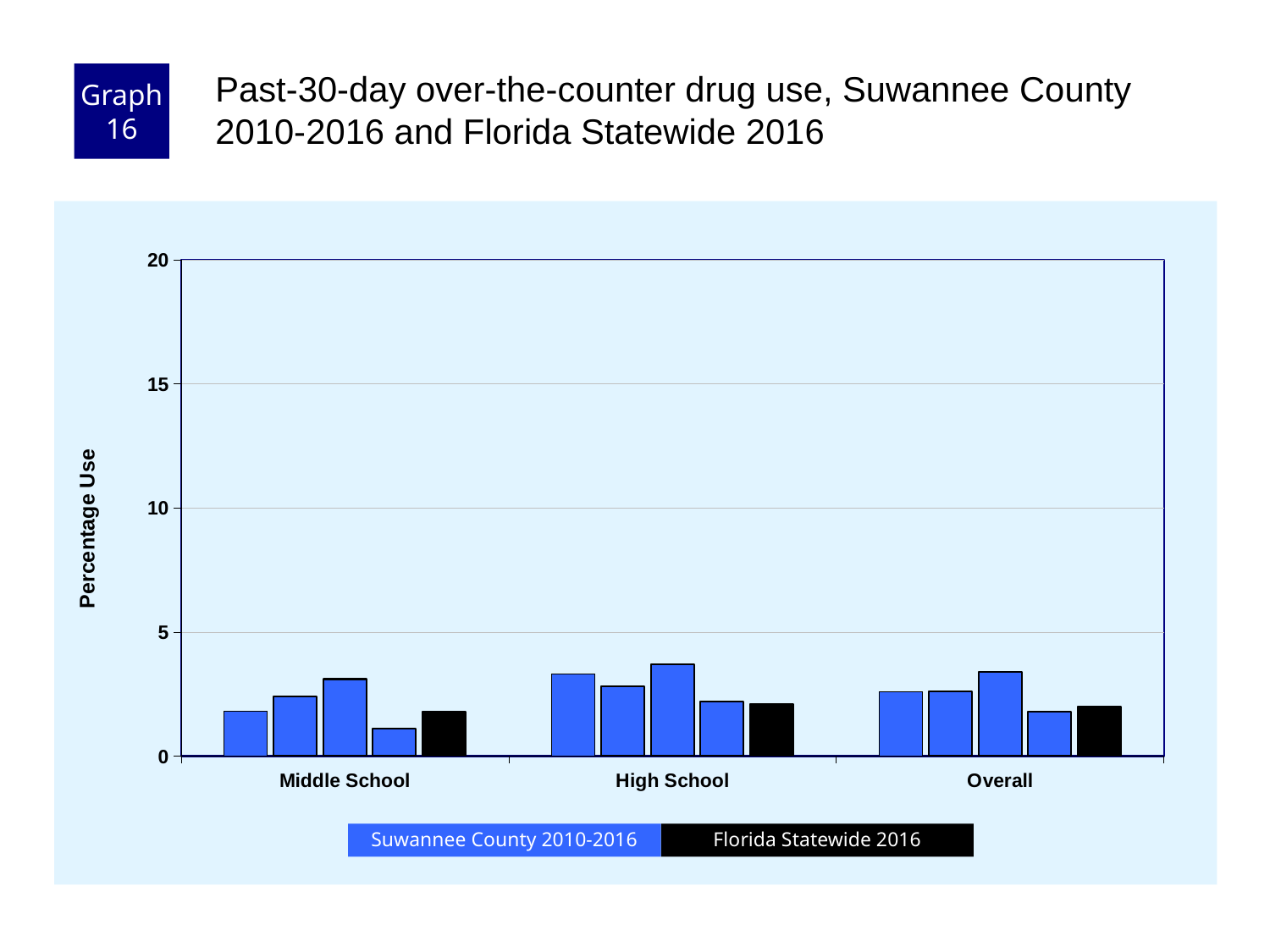
What kind of chart is shown on the slide? bar chart Are any bars on the chart greater than 10? No Is the value for Florida Statewide 2016 in the High School category greater or less than 5? less Is the value for Florida Statewide 2016 in the Overall category greater or less than 5? less Which colour represents Florida Statewide 2016 in the legend? black How many series does the legend list? 2 In which category does the shortest bar on the chart appear? Middle School How many categories are shown on the x axis? 3 In the High School category, which is larger: the tallest Suwannee County 2010-2016 bar or the Florida Statewide 2016 bar? Suwannee County 2010-2016 What is the title of the y axis? Percentage Use In the Middle School category, which is larger: the shortest Suwannee County 2010-2016 bar or the Florida Statewide 2016 bar? Florida Statewide 2016